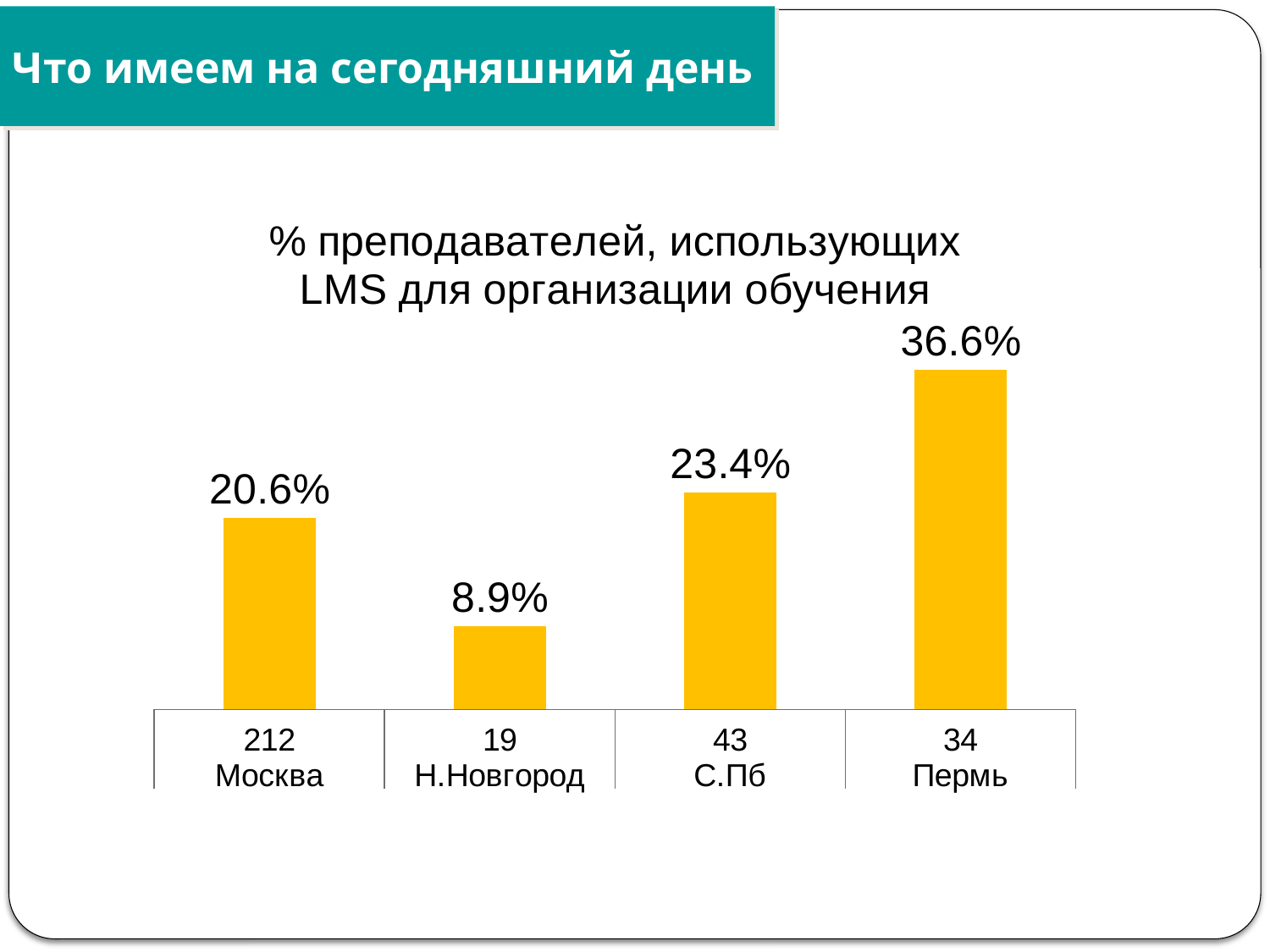
What is the value shown for Н.Новгород? 8.9% Which has a larger value, Москва or С.Пб? С.Пб What number is shown under the bar for Москва in the category label? 212 How many cities are shown in the chart? 4 Which city has the lowest percentage of teachers using LMS? Н.Новгород Which city has the highest percentage of teachers using LMS? Пермь What percentage of teachers use LMS in Москва? 20.6% What is the value shown for С.Пб? 23.4% What is the value shown for Пермь? 36.6% What is the difference between the values for Пермь and Москва? 16.0% What type of chart is shown on the slide? Bar chart What is the difference between the values for С.Пб and Н.Новгород? 14.5%